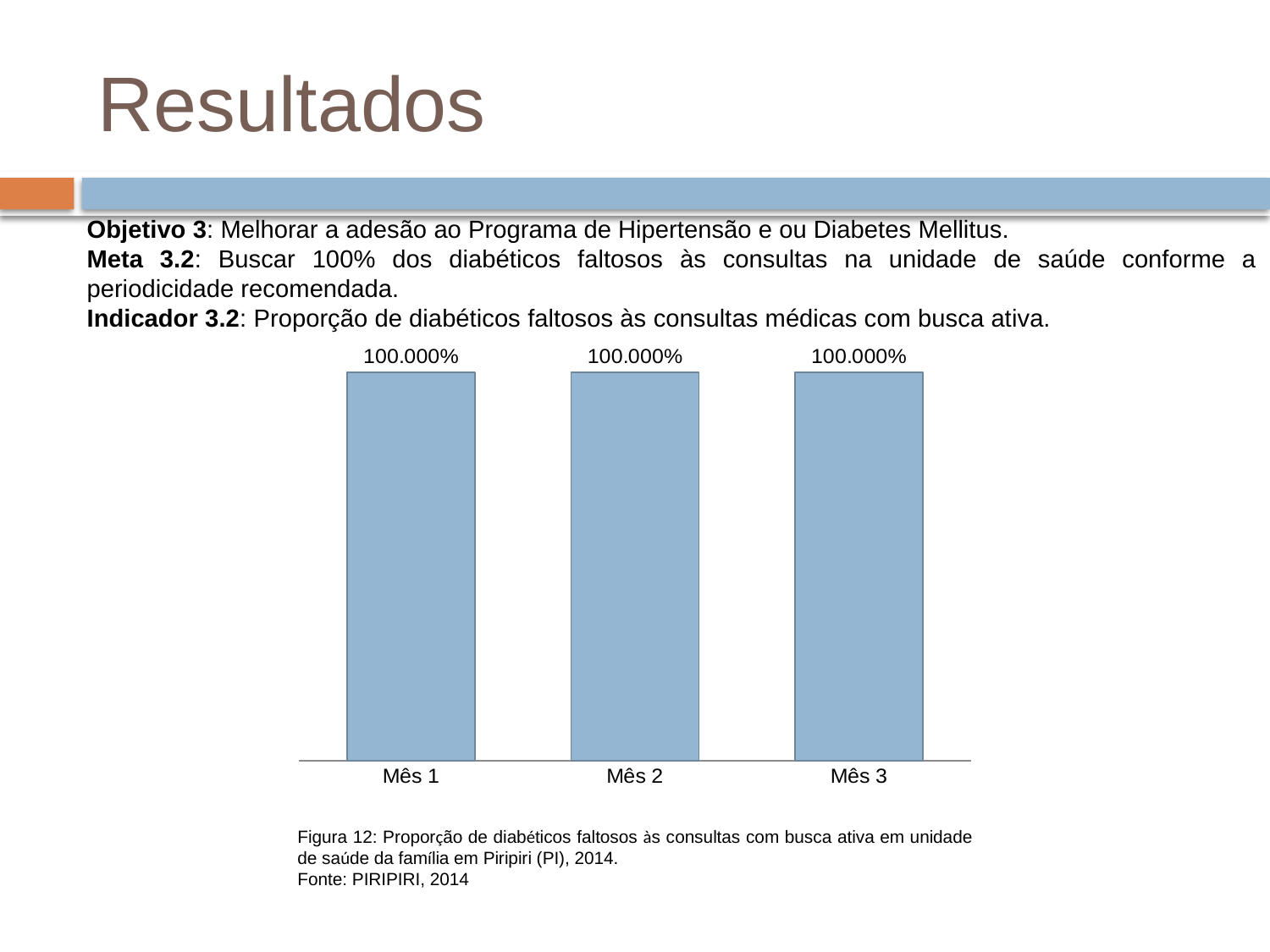
What is the value shown for Mês 3? 100.000% What is the value shown for Mês 1? 100.000% What is the label of the first category on the x axis? Mês 1 Do the values rise, fall, or stay the same from Mês 1 to Mês 3? Stay the same What is the value shown for Mês 2? 100.000% How many categories (months) are plotted in the chart? 3 What source is cited below the chart? PIRIPIRI, 2014 Is the value for Mês 2 larger than, smaller than, or equal to the value for Mês 1? Equal What kind of chart is shown on the slide? Bar chart What is the difference between the values for Mês 3 and Mês 1? 0.000%